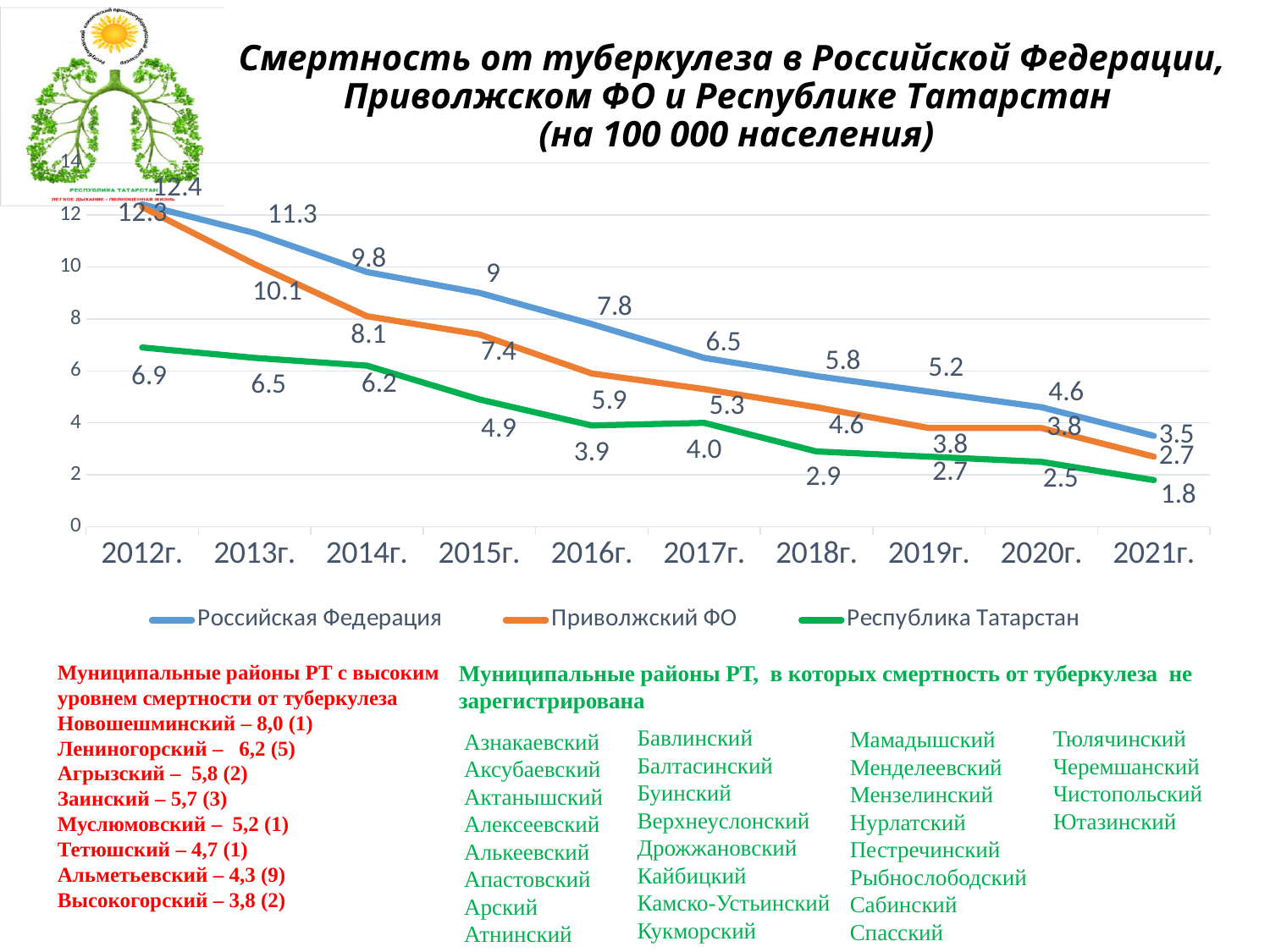
What is the value for Российская Федерация in 2014г.? 9.8 What is the difference between Российская Федерация and Республика Татарстан in 2018г.? 2.9 What is the value for Российская Федерация in 2021г.? 3.5 How many series does the legend list? 3 How many years are shown on the x axis? 10 Do the values for Российская Федерация rise or fall from 2012г. to 2021г.? fall Which is larger in 2019г., Приволжский ФО or Республика Татарстан? Приволжский ФО In which year is the value for Республика Татарстан lowest? 2021г. What is the value for Приволжский ФО in 2015г.? 7.4 Which series is drawn in green? Республика Татарстан What is the value for Республика Татарстан in 2016г.? 3.9 What type of chart is shown on the slide? line chart